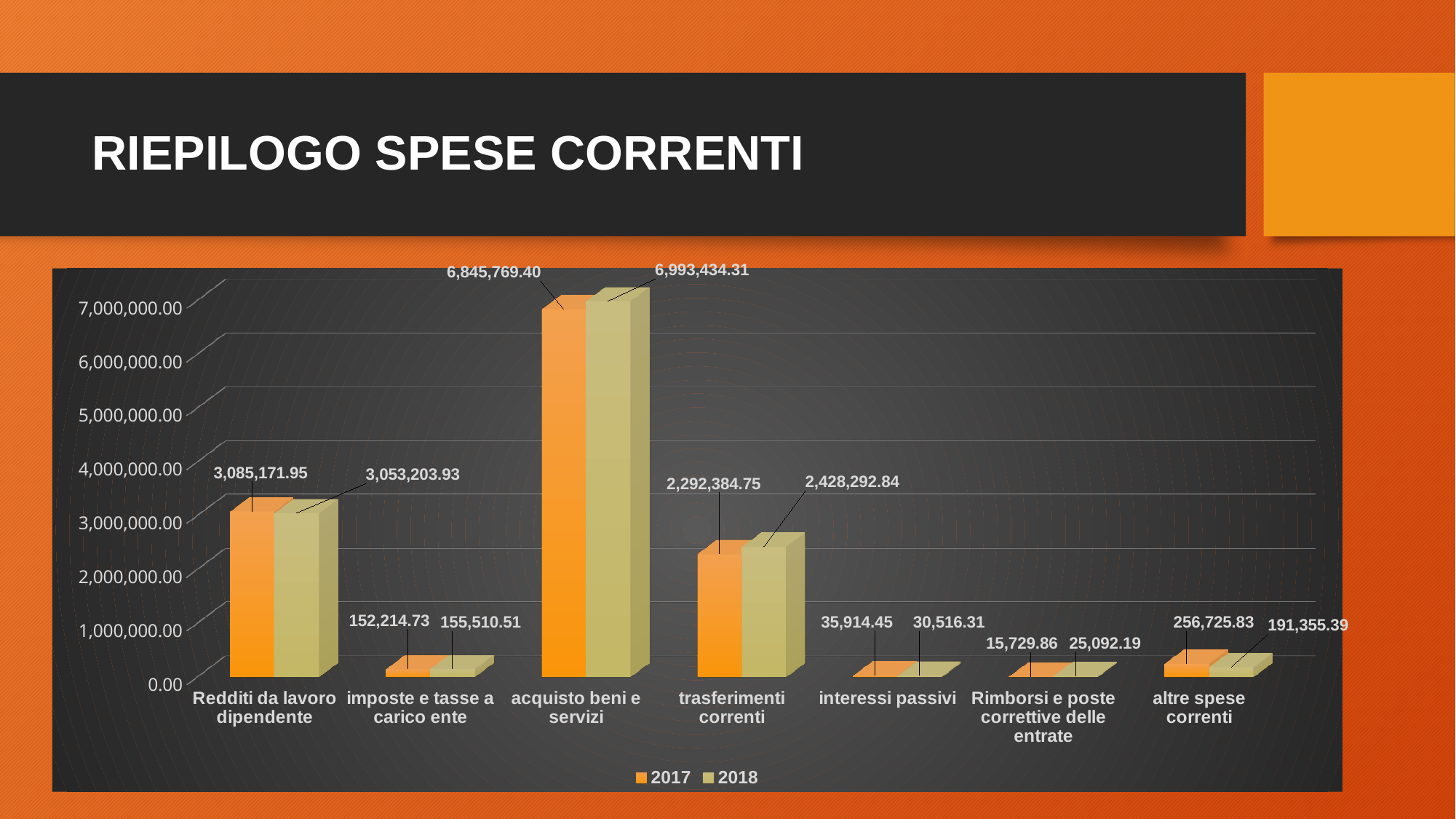
How many series does the legend list? 2 What is the 2017 value for acquisto beni e servizi? 6,845,769.40 How many categories are shown on the x axis? 7 What is the difference between the 2018 and 2017 values for acquisto beni e servizi? 147,664.91 What is the difference between the 2017 and 2018 values for altre spese correnti? 65,370.44 What is the 2018 value for Rimborsi e poste correttive delle entrate? 25,092.19 What is the 2018 value for trasferimenti correnti? 2,428,292.84 Which category has the lowest 2017 value? Rimborsi e poste correttive delle entrate What kind of chart is shown on the slide? bar chart What is the 2017 value for altre spese correnti? 256,725.83 For Redditi da lavoro dipendente, which year has the larger value, 2017 or 2018? 2017 Which category has the highest 2018 value? acquisto beni e servizi